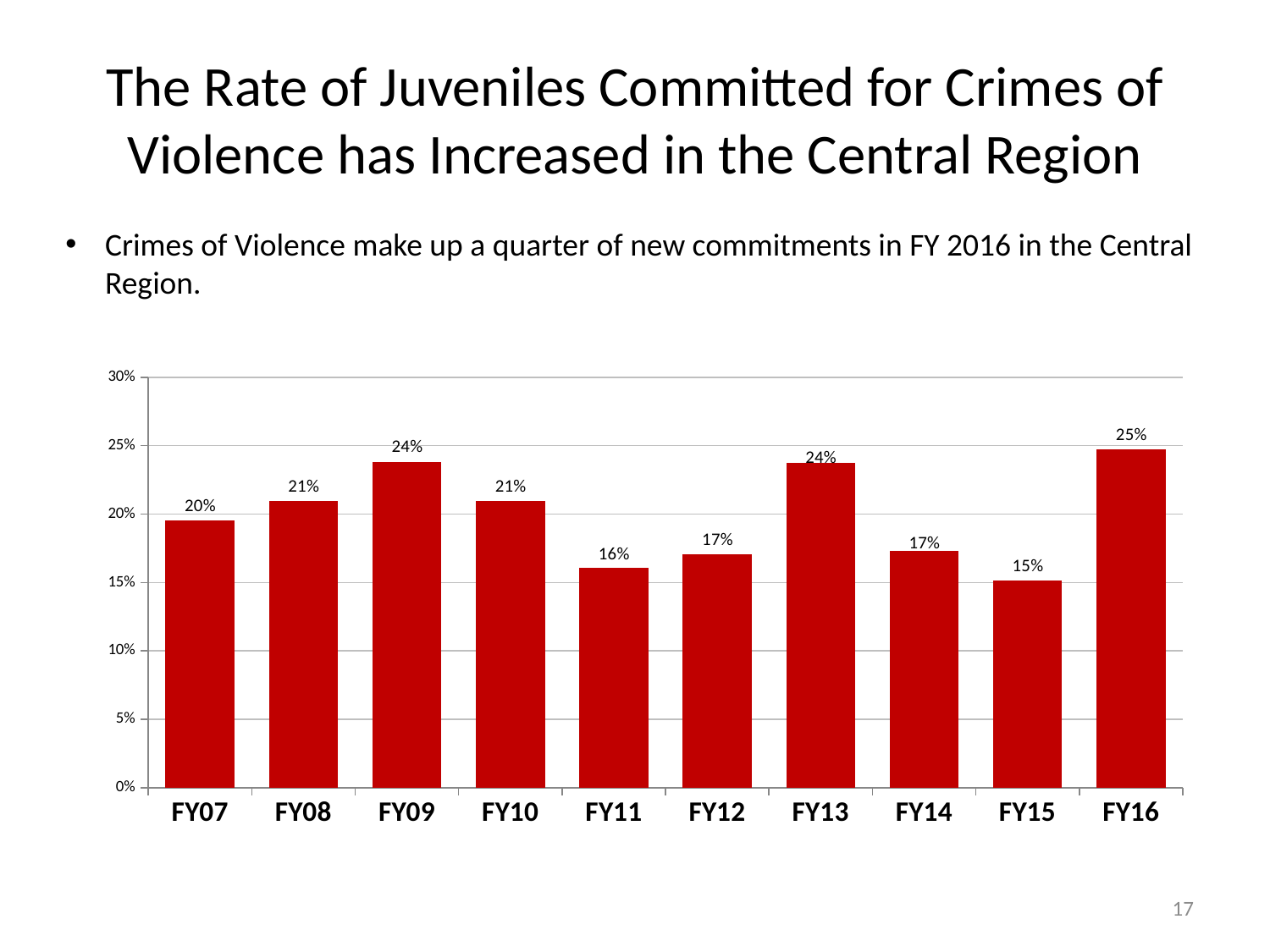
What is the difference between the values for FY16 and FY15? 10 percentage points What is the value for FY07? 20% Is the value for FY11 greater or less than 20%? less Do the values rise or fall from FY13 to FY15? fall How many fiscal years are shown on the x axis? 10 What is the value for FY16? 25% What is the value for FY11? 16% What colour are the bars in the chart? red Which fiscal year has the lowest value? FY15 What kind of chart is shown on the slide? bar chart Which is larger, the value for FY09 or the value for FY10? FY09 Which fiscal year has the highest value? FY16